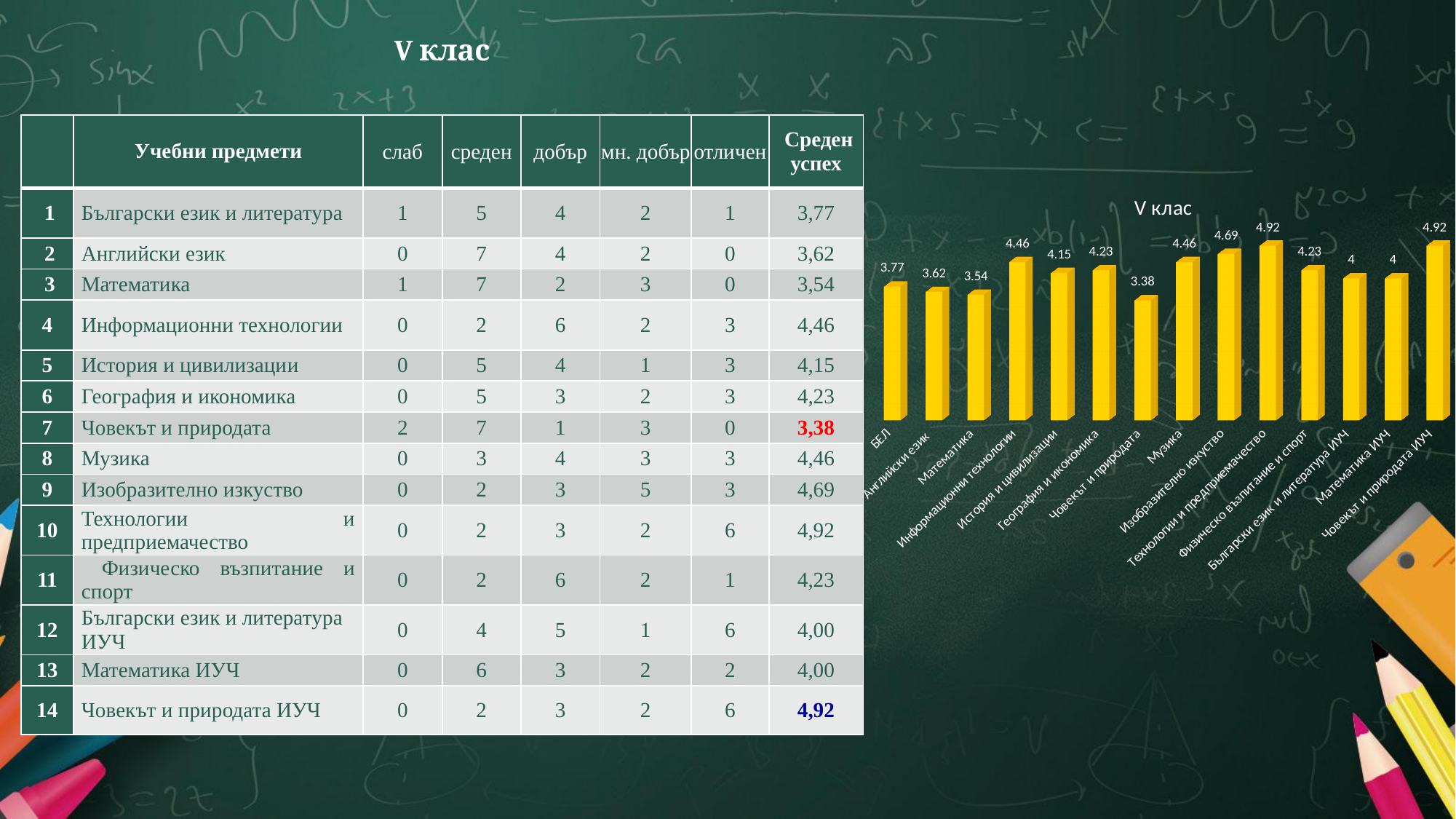
What colour are the bars in the chart? yellow What is the title of the chart? V клас How many bars does the chart have? 14 What type of chart is shown on the slide? bar chart What is the value for Математика ИУЧ in the chart? 4 Which category has the lowest value in the chart? Човекът и природата What is the difference between the values for Технологии и предприемачество and Физическо възпитание и спорт? 0.69 What is the value for История и цивилизации in the chart? 4.15 What is the difference between the values for Музика and БЕЛ? 0.69 Which is larger, the value for Английски език or the value for География и икономика? География и икономика What is the value for Математика in the chart? 3.54 What is the value for Изобразително изкуство in the chart? 4.69